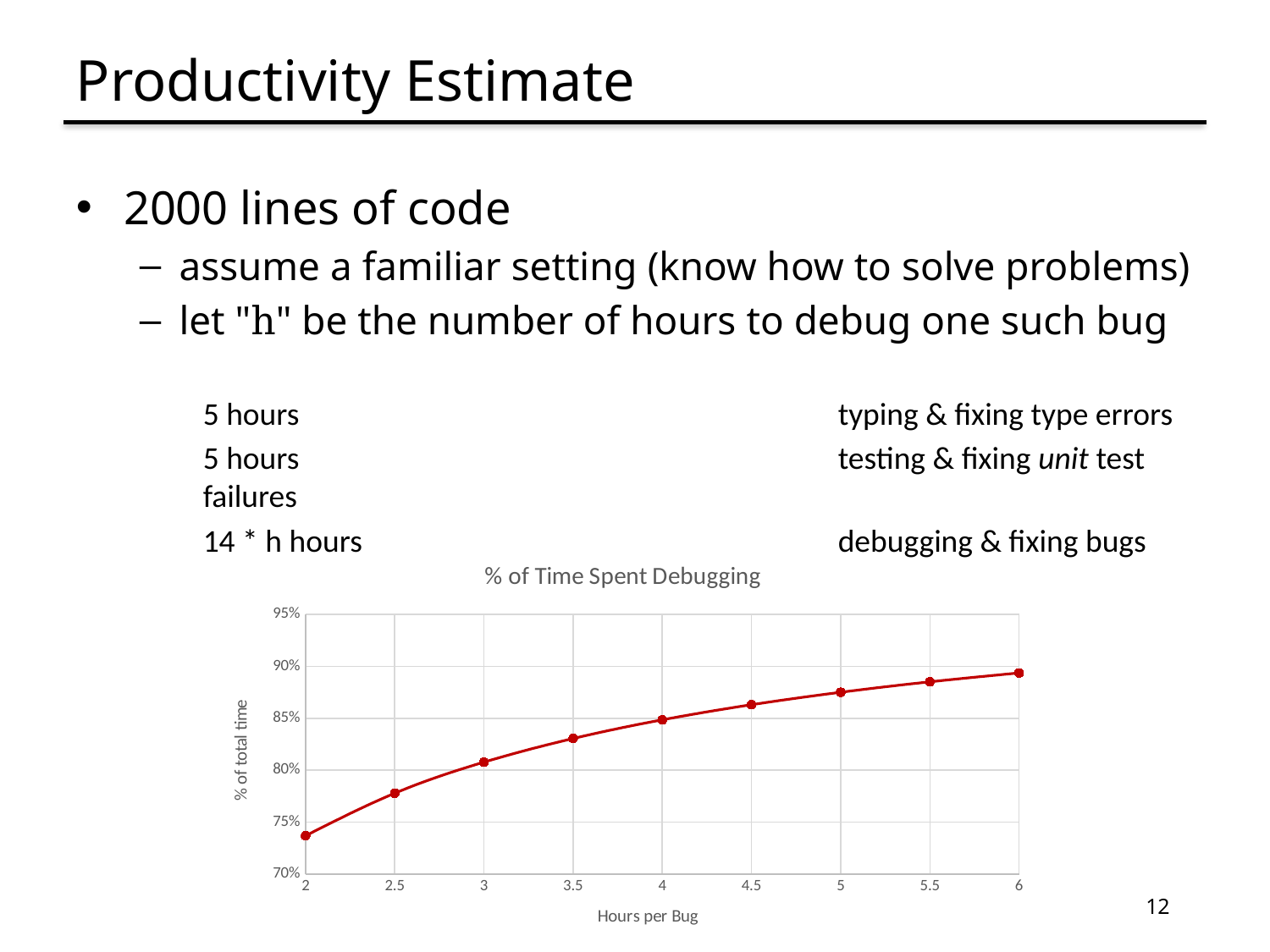
Is the value for 3.5 Hours per Bug greater or less than 80%? greater Is the value for 2 Hours per Bug greater or less than 75%? less At which value of Hours per Bug is the % of total time highest? 6 At which value of Hours per Bug is the % of total time lowest? 2 Does the % of total time rise or fall as Hours per Bug increases? rises How many data points are plotted on the line? 9 Is the value for 6 Hours per Bug greater or less than 90%? less Which is larger, the value at 3 Hours per Bug or the value at 5 Hours per Bug? 5 Hours per Bug What kind of chart is shown on the slide? line chart What is the title of the chart? % of Time Spent Debugging What is the label of the x axis of the chart? Hours per Bug